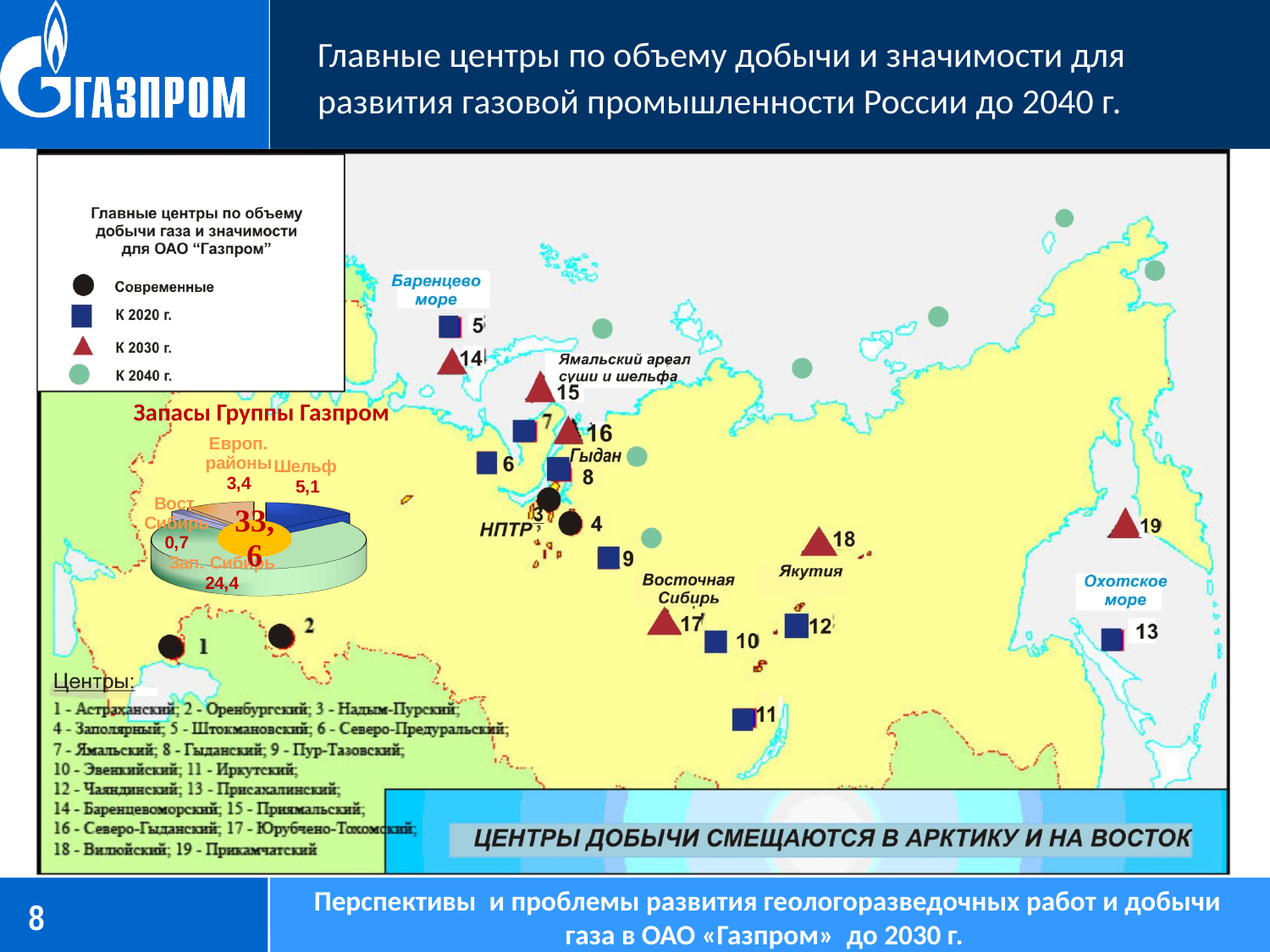
In the "Запасы Группы Газпром" pie chart, what is the difference between the values for Шельф and Европ. районы? 1,7 In the "Запасы Группы Газпром" pie chart, what is the value for Европ. районы? 3,4 In the "Запасы Группы Газпром" pie chart, what is the value for Шельф? 5,1 In the "Запасы Группы Газпром" pie chart, what is the value for Зап. Сибирь? 24,4 In the "Запасы Группы Газпром" pie chart, which category has the smallest value? Вост. Сибирь How many categories (slices) does the "Запасы Группы Газпром" pie chart show? 4 In the "Запасы Группы Газпром" pie chart, what is the difference between the values for Зап. Сибирь and Шельф? 19,3 In the "Запасы Группы Газпром" pie chart, which category has the largest value? Зап. Сибирь In the "Запасы Группы Газпром" pie chart, which is larger: Шельф or Европ. районы? Шельф In the "Запасы Группы Газпром" pie chart, what is the value for Вост. Сибирь? 0,7 What total value is printed in the centre of the "Запасы Группы Газпром" pie chart? 33,6 What kind of chart is the "Запасы Группы Газпром" chart on the slide? pie chart